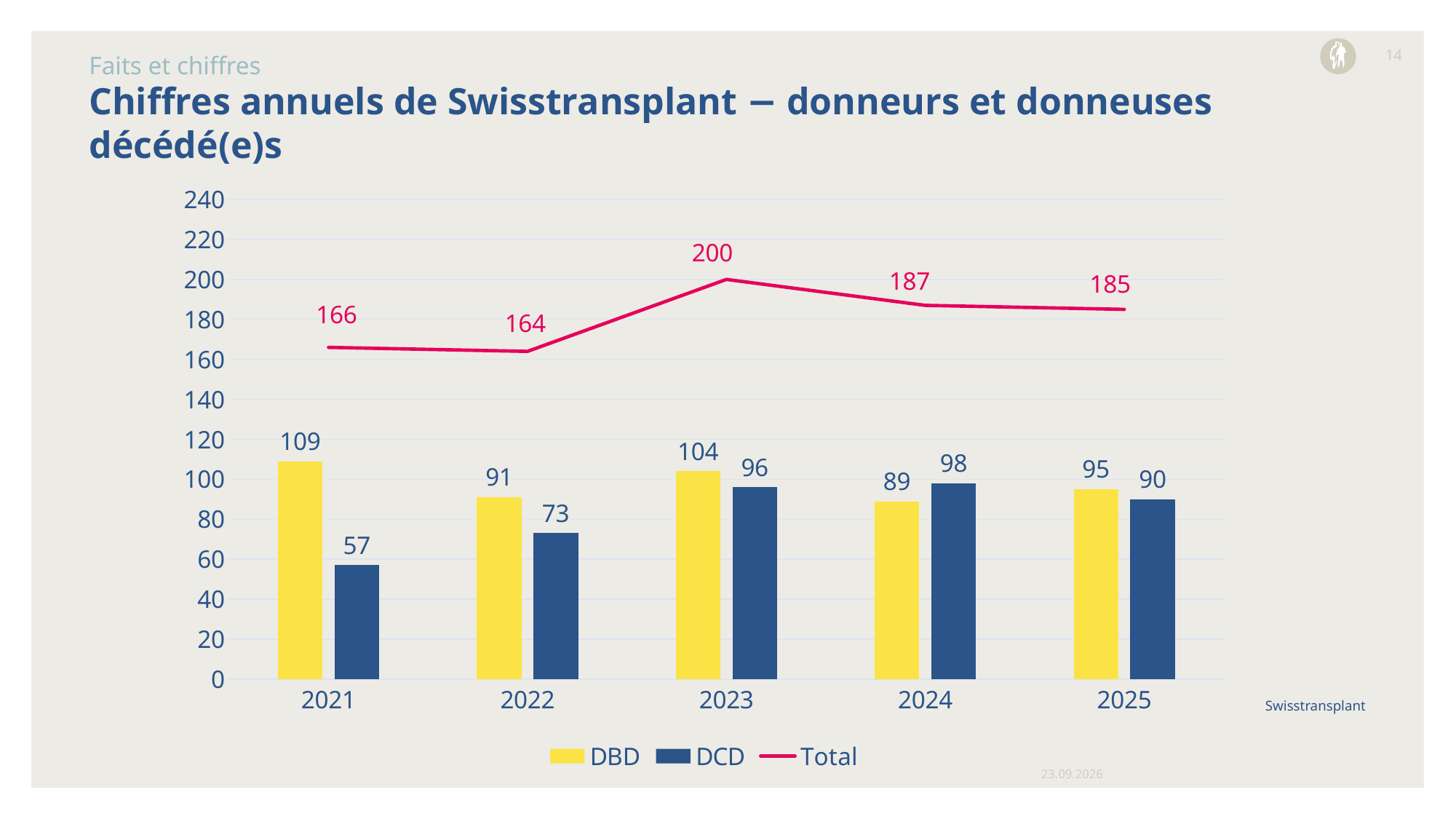
Is the Total value for 2022 greater or less than 180? less How many years are shown on the x axis? 5 How many series does the legend list? 3 What kind of chart is shown on the slide? Combined bar and line chart Which year has the highest Total value? 2023 What is the DBD value for 2021? 109 What is the DCD value for 2024? 98 Which year has the lowest DCD value? 2021 What is the difference between the DBD and DCD values in 2021? 52 Which is larger in 2024, the DBD value or the DCD value? DCD What is the Total value for 2023? 200 Does the Total value rise or fall from 2023 to 2025? fall